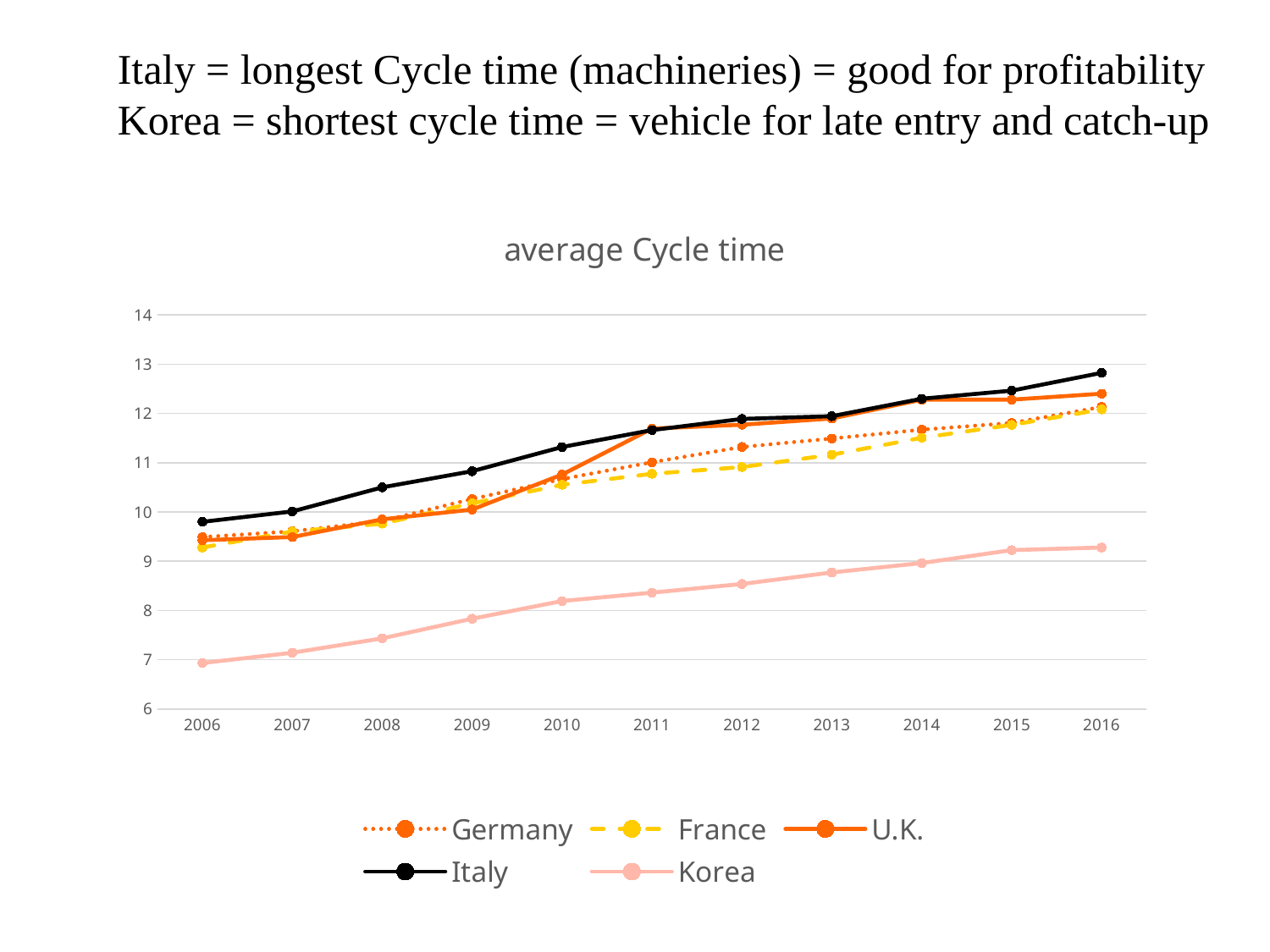
Is the value for Korea in 2010 greater or less than 8? greater How many series does the legend list? 5 Which country has the highest average cycle time in 2016? Italy Does the average cycle time for Korea rise or fall from 2006 to 2016? rise What is the title of the chart? average Cycle time Is the value for Italy in 2016 greater or less than 12? greater Is the value for Korea in 2016 greater or less than 10? less In 2013, which is larger, the value for Germany or the value for France? Germany What kind of chart is shown on the slide? line chart In 2012, which is larger, the value for Italy or the value for Korea? Italy Which country has the lowest average cycle time in 2016? Korea How many years are shown on the x axis? 11